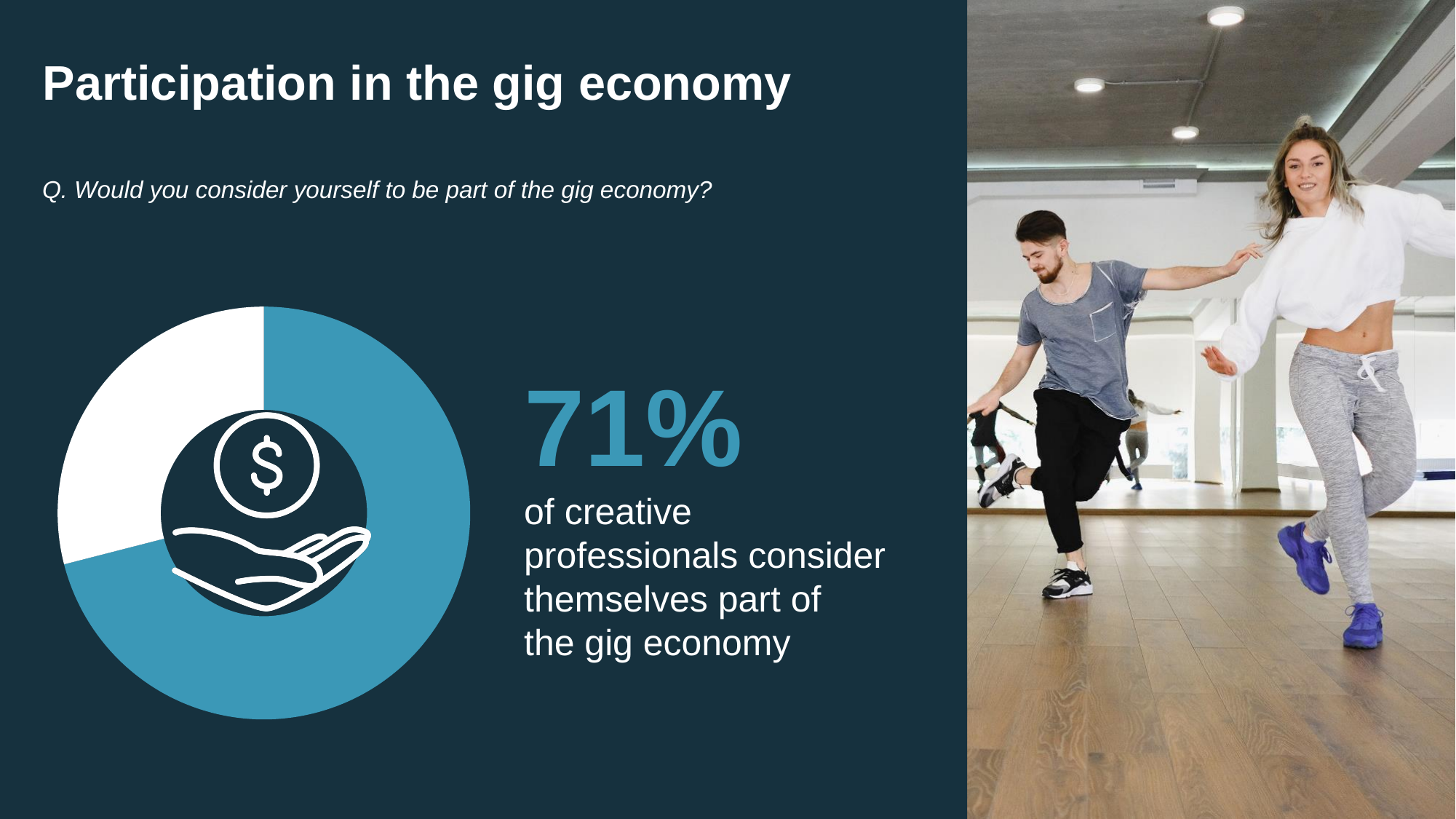
What kind of chart is shown on the slide? doughnut chart How many slices does the pie chart have? 2 What percentage of creative professionals consider themselves part of the gig economy? 71% Which slice is the largest in the pie chart? the blue slice (71%) Which slice of the pie chart is larger, the blue one or the white one? the blue one Is the white slice of the pie chart greater or less than 50%? less What survey question does the chart on the slide answer? Would you consider yourself to be part of the gig economy? Is the blue slice of the pie chart greater or less than 50%? greater What share of the pie does the blue slice represent? 71% What is the title of the slide containing the chart? Participation in the gig economy